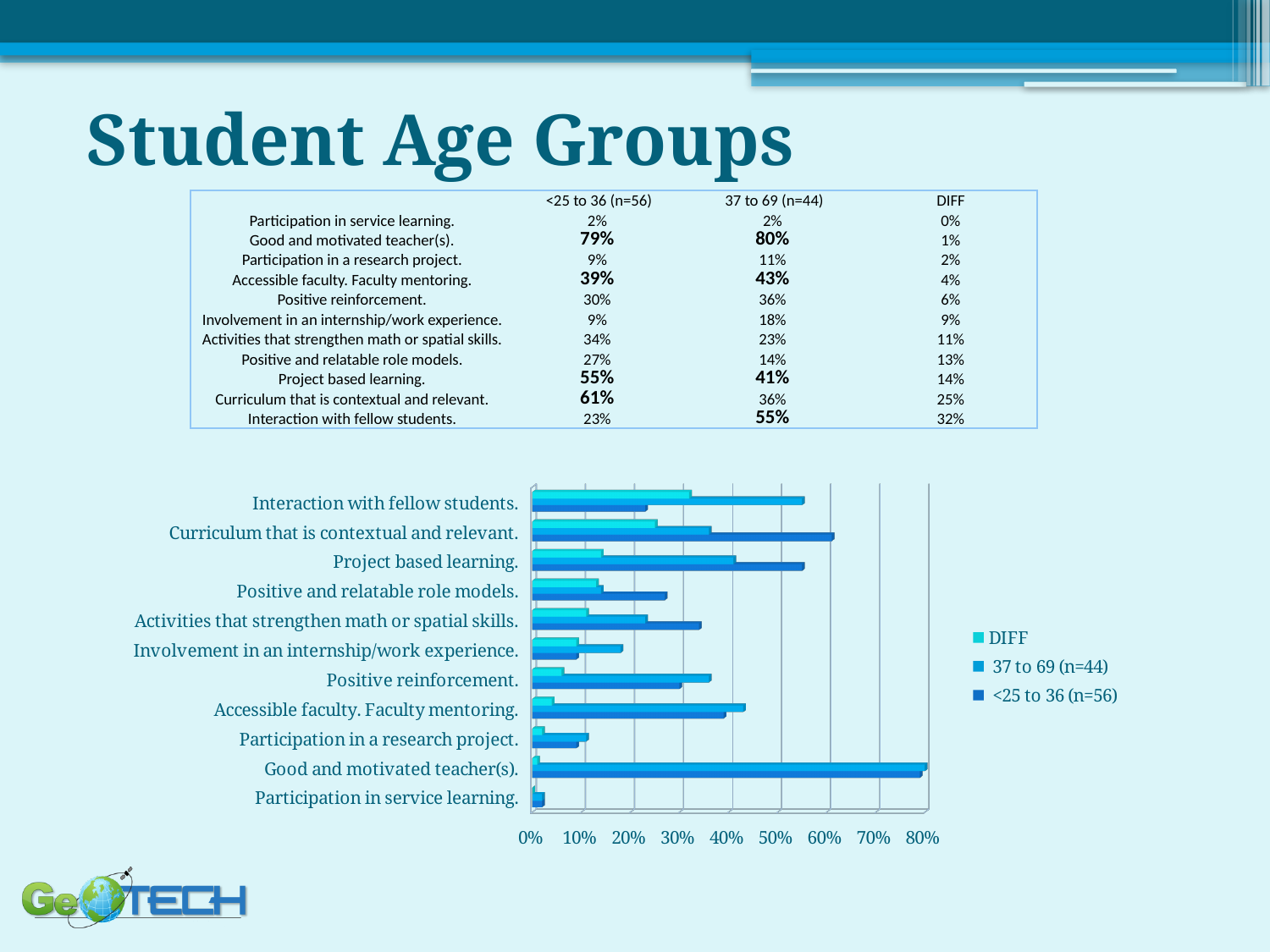
What are the three entries listed in the chart legend? DIFF, 37 to 69 (n=44), <25 to 36 (n=56) What is the value for '<25 to 36 (n=56)' for 'Curriculum that is contextual and relevant'? 61% What is the difference between the '<25 to 36 (n=56)' and '37 to 69 (n=44)' values for 'Project based learning'? 14% How many categories are plotted on the chart's vertical axis? 11 Which category has the highest value for the '<25 to 36 (n=56)' series? Good and motivated teacher(s). Is the '37 to 69 (n=44)' bar for 'Good and motivated teacher(s)' greater or less than 70%? greater For 'Activities that strengthen math or spatial skills', which series has the larger value, '<25 to 36 (n=56)' or '37 to 69 (n=44)'? <25 to 36 (n=56) How many series does the chart legend list? 3 What type of chart is shown on the slide? Bar chart Is the DIFF bar for 'Positive reinforcement' greater or less than 10%? less Which category has the lowest DIFF value? Participation in service learning. What is the value for '37 to 69 (n=44)' for 'Interaction with fellow students'? 55%